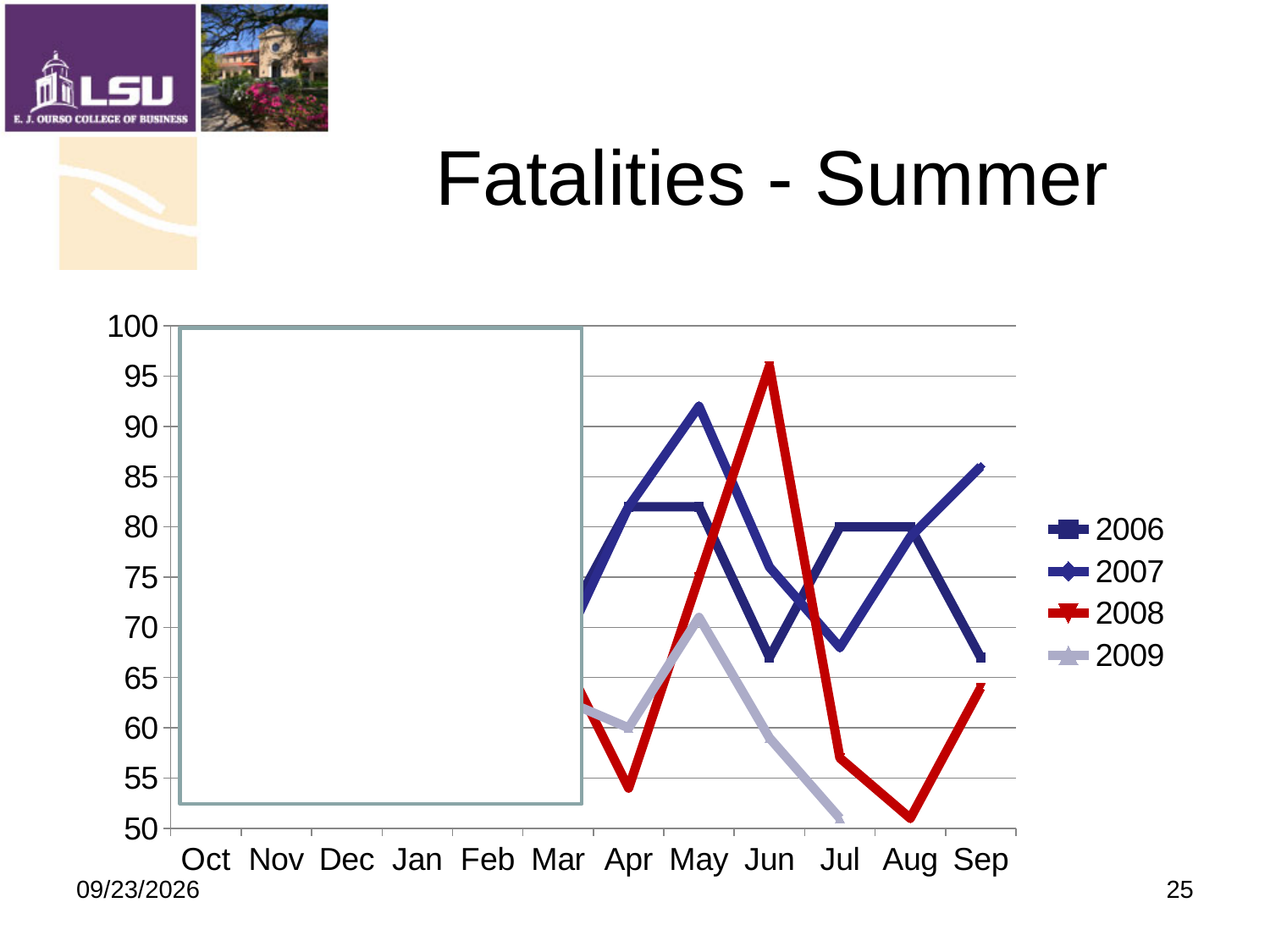
Is the value for 2008 in Jun greater or less than 90? greater Does the 2009 series rise or fall from May to Jul? fall What is the title of the chart? Fatalities - Summer How many months are labelled along the x axis? 12 Is the value for 2008 in Aug greater or less than 55? less In which month does the 2008 series reach its highest value? Jun Is the value for 2009 in Jul greater or less than 55? less What colour is the 2008 line? red What kind of chart is shown on the slide? line chart In Jun, which series has the larger value, 2008 or 2009? 2008 How many series does the legend list? 4